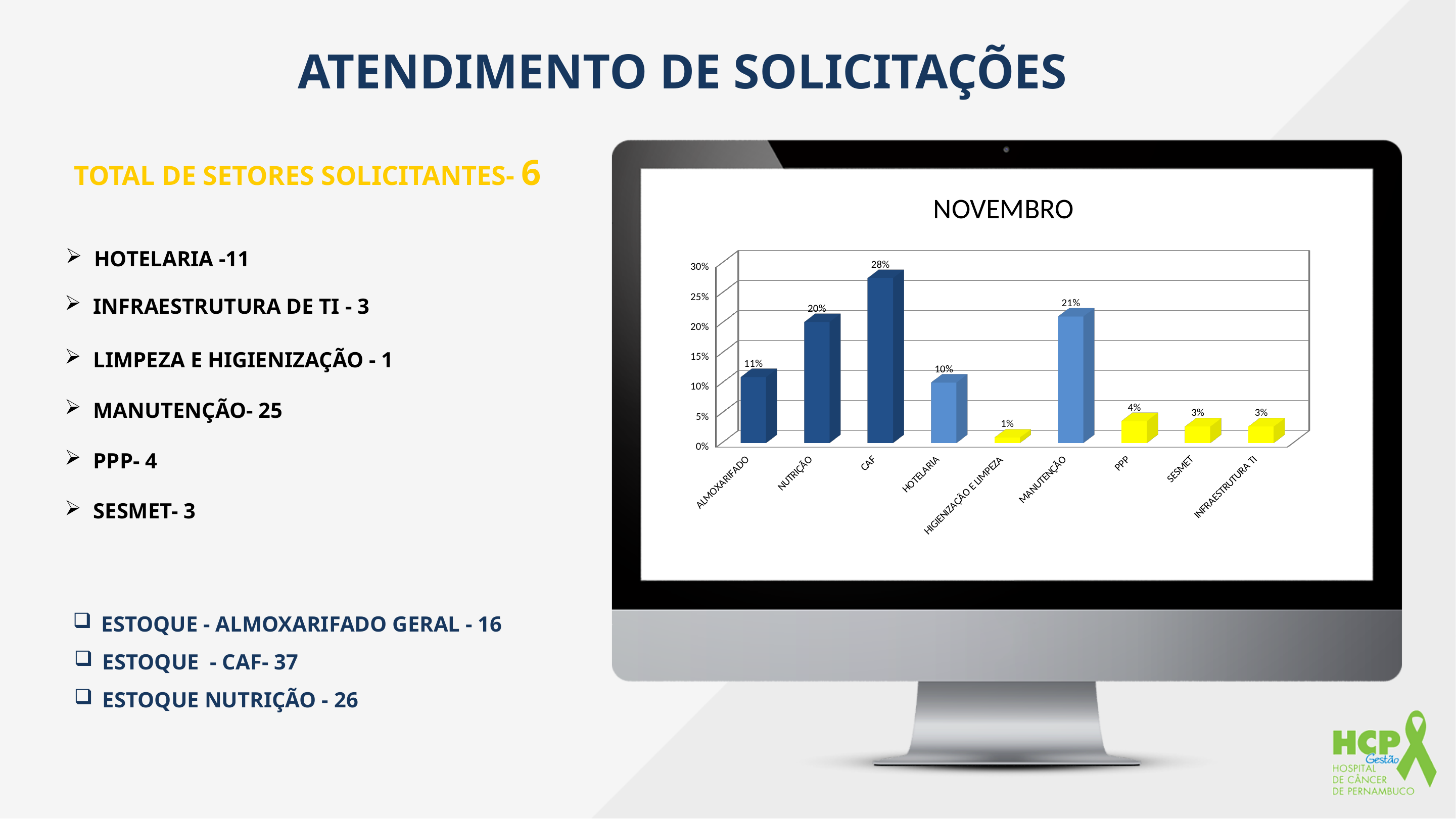
What is the value for MANUTENÇÃO in the NOVEMBRO chart? 21% What is the difference between the values for CAF and NUTRIÇÃO in the NOVEMBRO chart? 8% What is the value for HIGIENIZAÇÃO E LIMPEZA in the NOVEMBRO chart? 1% What is the title of the chart on the slide? NOVEMBRO Which category has the lowest value in the NOVEMBRO chart? HIGIENIZAÇÃO E LIMPEZA Which category has the highest value in the NOVEMBRO chart? CAF What kind of chart is the NOVEMBRO chart? Bar chart Which is larger in the NOVEMBRO chart, the value for NUTRIÇÃO or the value for HOTELARIA? NUTRIÇÃO What is the value for CAF in the NOVEMBRO chart? 28% Is the value for MANUTENÇÃO in the NOVEMBRO chart greater or less than 15%? greater How many categories are shown on the x axis of the NOVEMBRO chart? 9 What is the value for ALMOXARIFADO in the NOVEMBRO chart? 11%